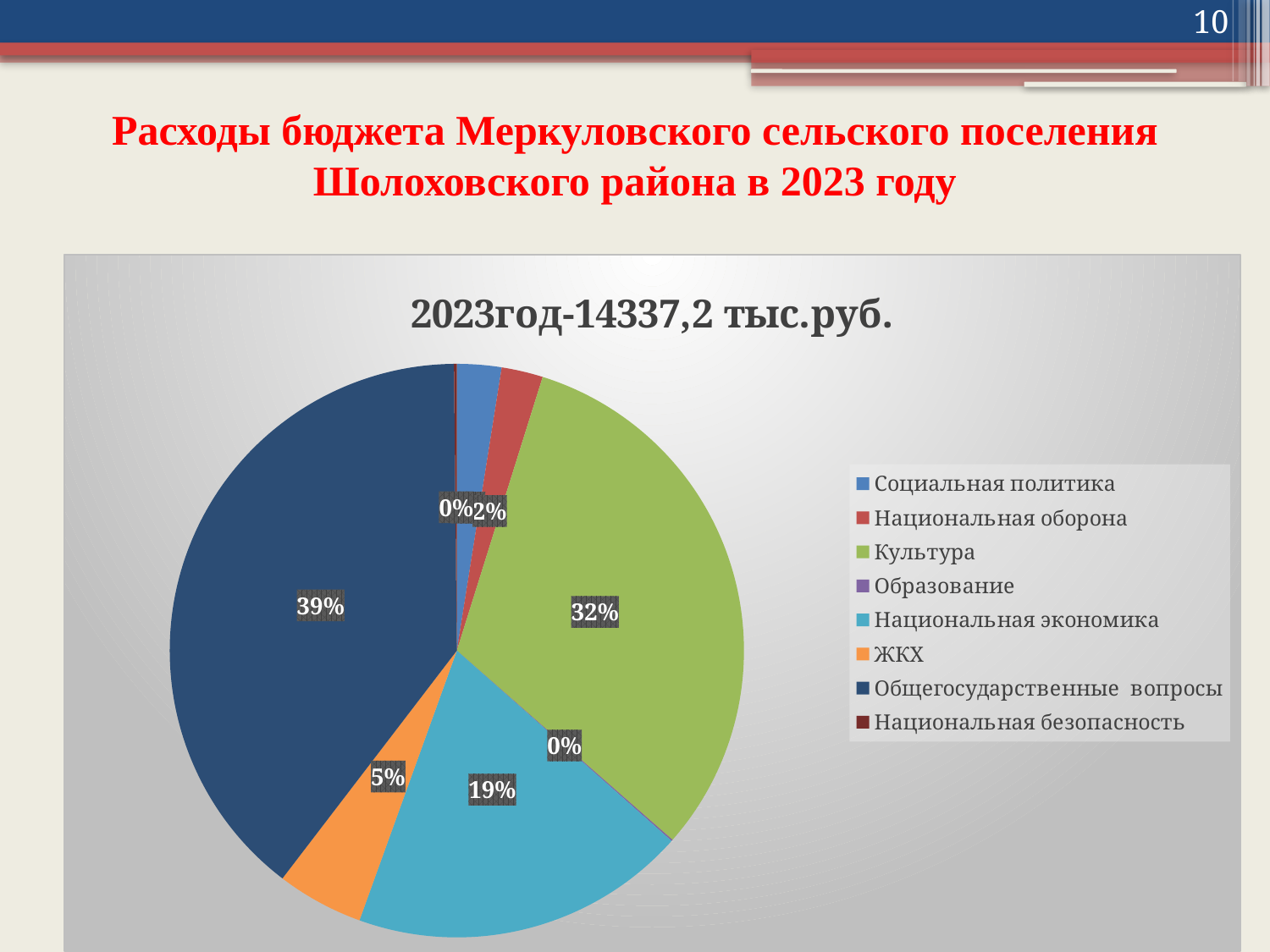
What is the difference in percentage points between the shares of Национальная экономика and ЖКХ? 14 How many categories does the chart legend list? 8 What type of chart is shown on the slide? pie chart Which category has the largest share of the pie? Общегосударственные вопросы What is the title of the chart? 2023год-14337,2 тыс.руб. What colour is the slice for Культура? green What is the difference in percentage points between the shares of Общегосударственные вопросы and Культура? 7 Which is larger, the share for Культура or the share for Национальная экономика? Культура What share of the pie does Общегосударственные вопросы represent? 39% What share of the pie does Национальная экономика represent? 19% What share of the pie does ЖКХ represent? 5%